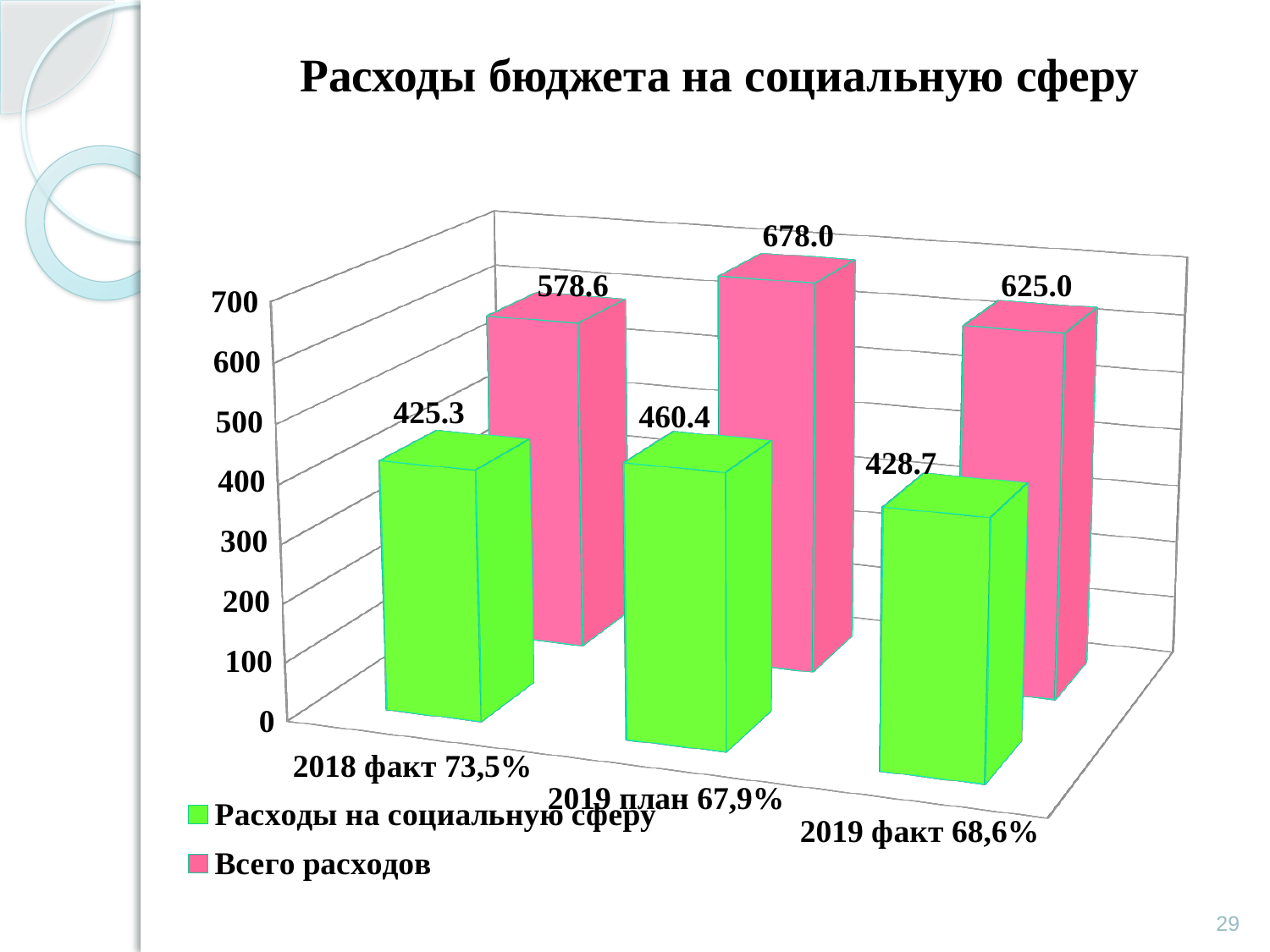
How many series does the legend list? 2 What is the title of the chart? Расходы бюджета на социальную сферу What kind of chart is shown on the slide? Bar chart Which category has the lowest value for "Расходы на социальную сферу"? 2018 факт 73,5% What is the difference between "Всего расходов" and "Расходы на социальную сферу" for "2019 план 67,9%"? 217.6 Which is larger: "Всего расходов" for "2018 факт 73,5%" or "Всего расходов" for "2019 факт 68,6%"? 2019 факт 68,6% What is the value of "Расходы на социальную сферу" for "2018 факт 73,5%"? 425.3 What is the value of "Всего расходов" for "2019 план 67,9%"? 678.0 How many categories are shown on the x axis? 3 What is the value of "Расходы на социальную сферу" for "2019 факт 68,6%"? 428.7 Which category has the highest value for "Всего расходов"? 2019 план 67,9% What is the value of "Всего расходов" for "2019 факт 68,6%"? 625.0